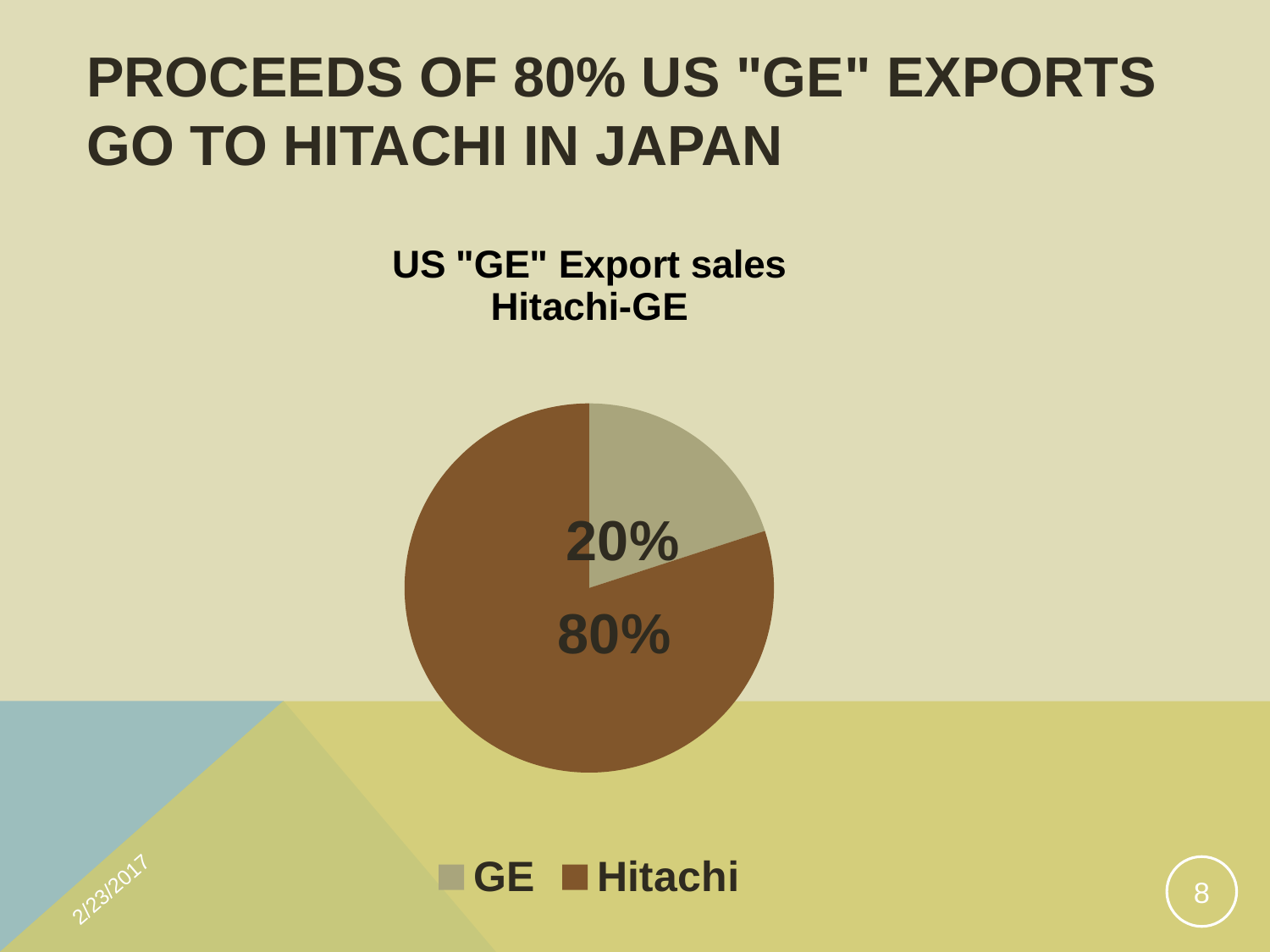
How many slices does the pie chart have? 2 What colour is the Hitachi slice in the pie chart? brown What share of the pie does GE have? 20% What share of the pie does Hitachi have? 80% What is the total of the two slices shown in the pie chart? 100% Which slice of the pie is the largest? Hitachi What kind of chart is shown on the slide? pie chart Which slice of the pie is the smallest? GE Which is larger, the GE slice or the Hitachi slice? Hitachi How many entries does the legend list? 2 What is the title of the chart? US "GE" Export sales Hitachi-GE What is the difference between the Hitachi share and the GE share? 60%